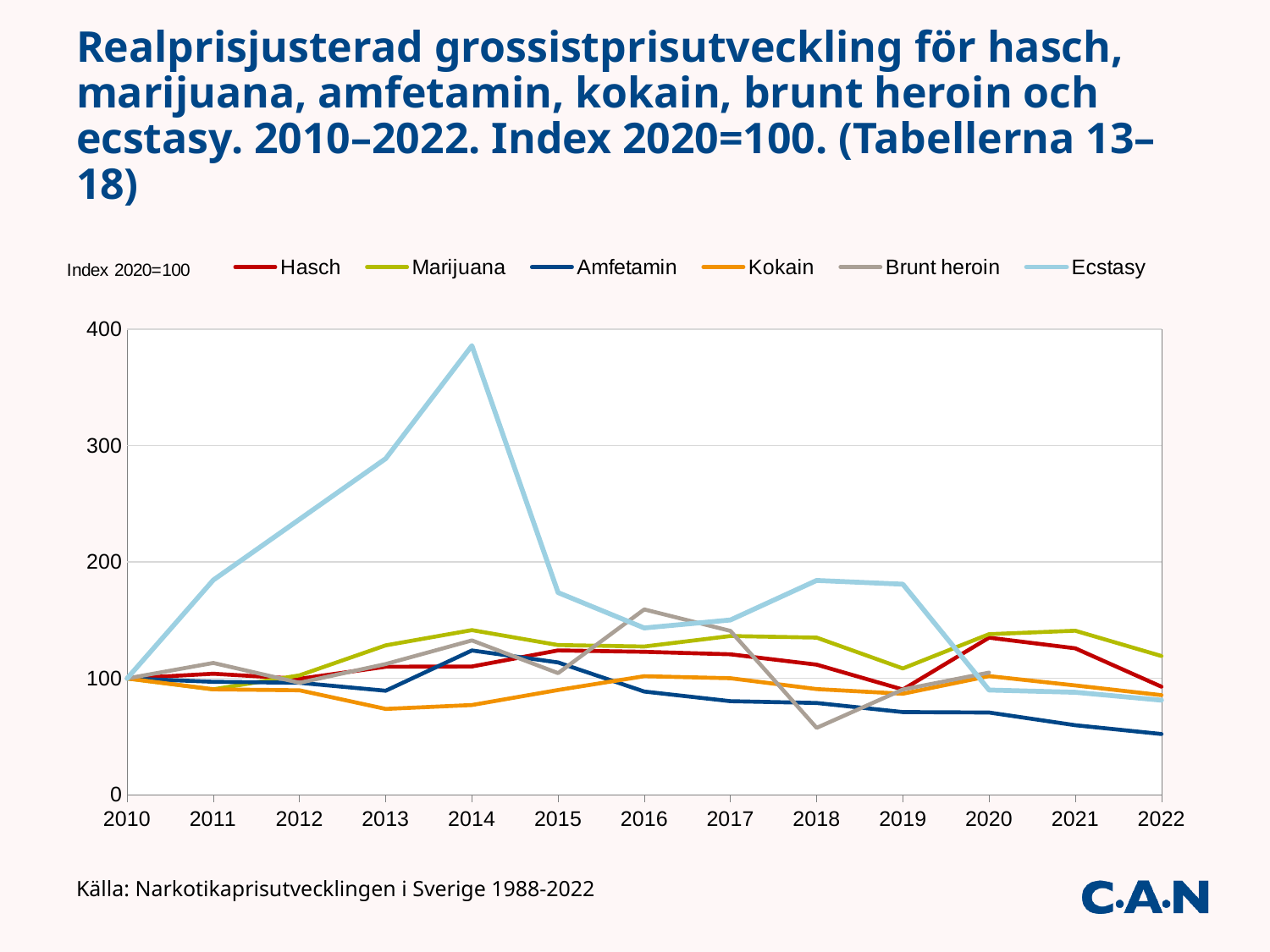
Is the value for Brunt heroin in 2018 greater or less than 100? less Which series has the highest value in 2014? Ecstasy What is the value for Hasch in 2010? 100 Which series has the lowest value in 2018? Brunt heroin Is the value for Ecstasy in 2014 greater or less than 300? greater Which series has the lowest value in 2022? Amfetamin Does the Ecstasy line rise or fall from 2010 to 2014? rise How many series does the legend list? 6 How many years are shown along the x axis? 13 What kind of chart is shown on the slide? line chart Which is larger in 2020, the value for Marijuana or the value for Kokain? Marijuana Is the value for Ecstasy in 2012 greater or less than 200? greater